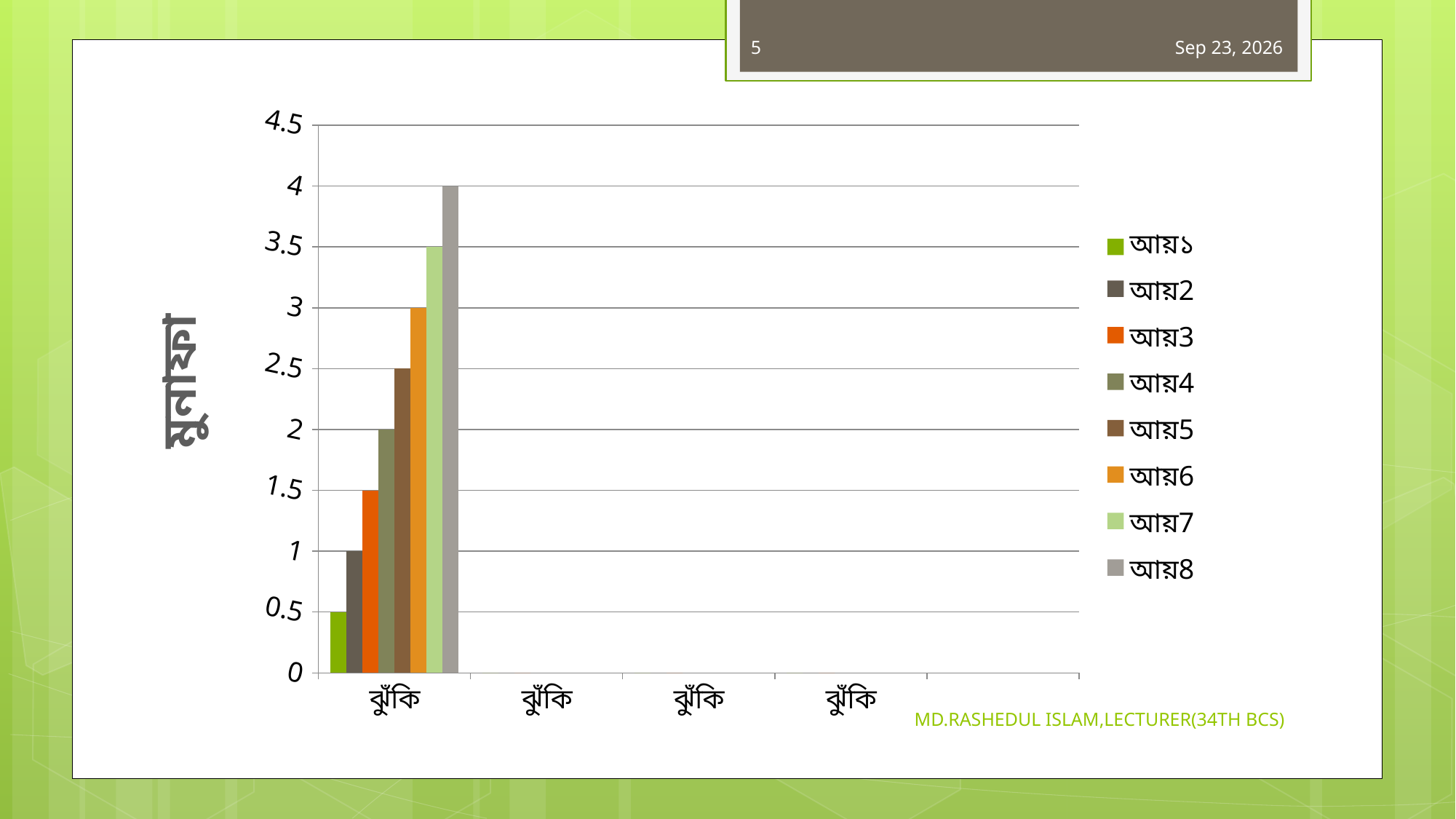
What is the difference between the আয়6 bar and the আয়3 bar in the first ঝুঁকি category? 1.5 What kind of chart is shown on the slide? bar chart What is the value of the আয়১ bar in the first ঝুঁকি category? 0.5 What is the title of the vertical axis? মুনাফা Which series has the tallest bar in the first ঝুঁকি category? আয়4 (the grey bar, last in the legend) How many categories are shown along the x axis? 4 What is the value of the আয়6 bar in the first ঝুঁকি category? 3 What is the value of the আয়7 bar in the first ঝুঁকি category? 3.5 What is the value of the আয়3 bar in the first ঝুঁকি category? 1.5 How many series does the legend list? 8 What is the value of the আয়2 bar in the first ঝুঁকি category? 1 Which series has the shortest bar in the first ঝুঁকি category? আয়১